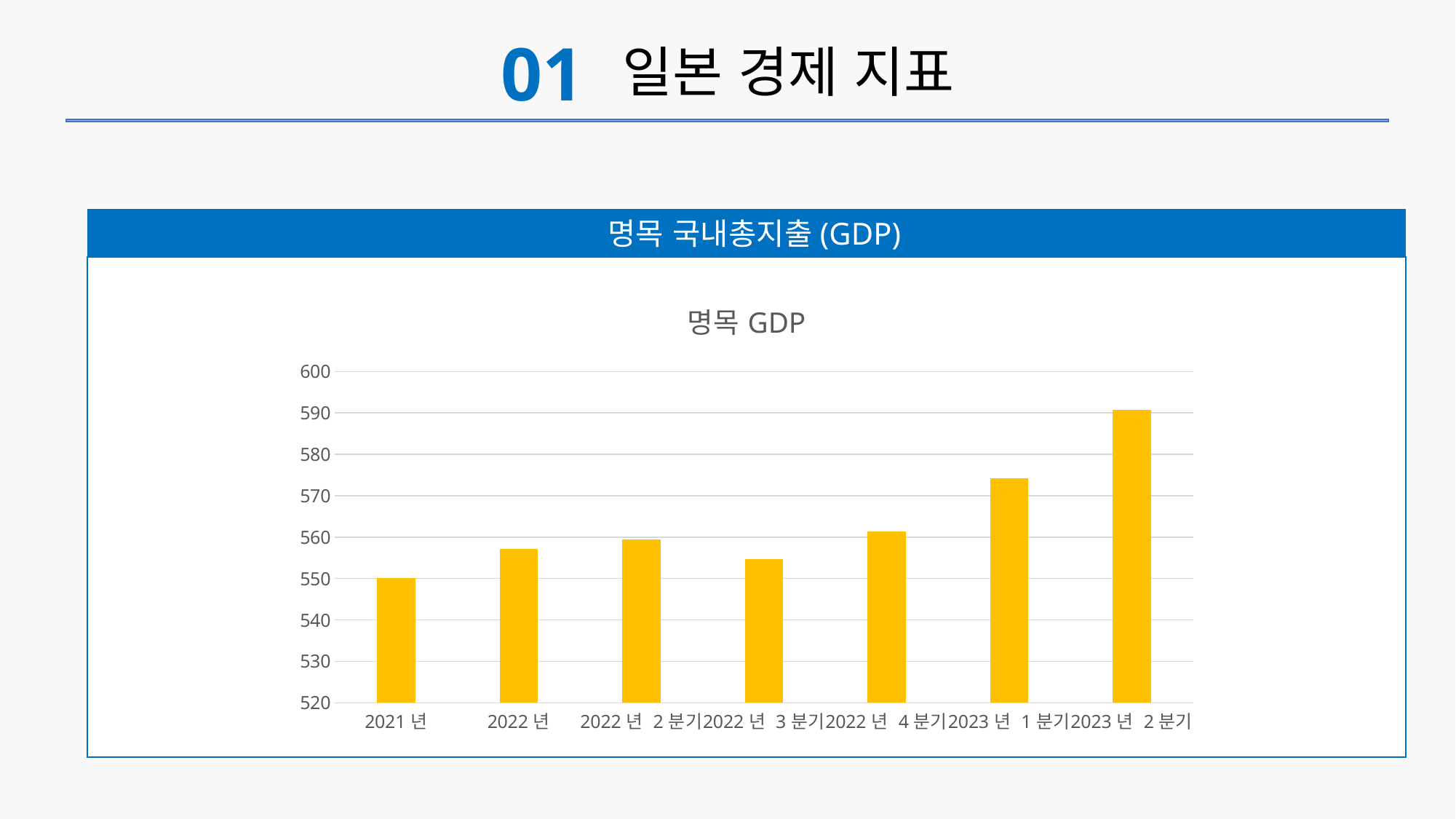
Is the value for 2023 년 2 분기 greater or less than 580? greater What is the title of the chart? 명목 GDP Is the value for 2021 년 greater or less than 560? less Which category has the highest value in the chart? 2023 년 2 분기 What kind of chart is shown on the slide? Bar chart Is the value for 2022 년 3 분기 greater or less than 560? less Which is larger, the value for 2022 년 2 분기 or the value for 2022 년 3 분기? 2022 년 2 분기 Which category has the lowest value in the chart? 2021 년 How many bars (categories) are plotted in the chart? 7 Overall, do the values rise or fall from 2021 년 to 2023 년 2 분기? Rise Which is larger, the value for 2023 년 1 분기 or the value for 2022 년 4 분기? 2023 년 1 분기